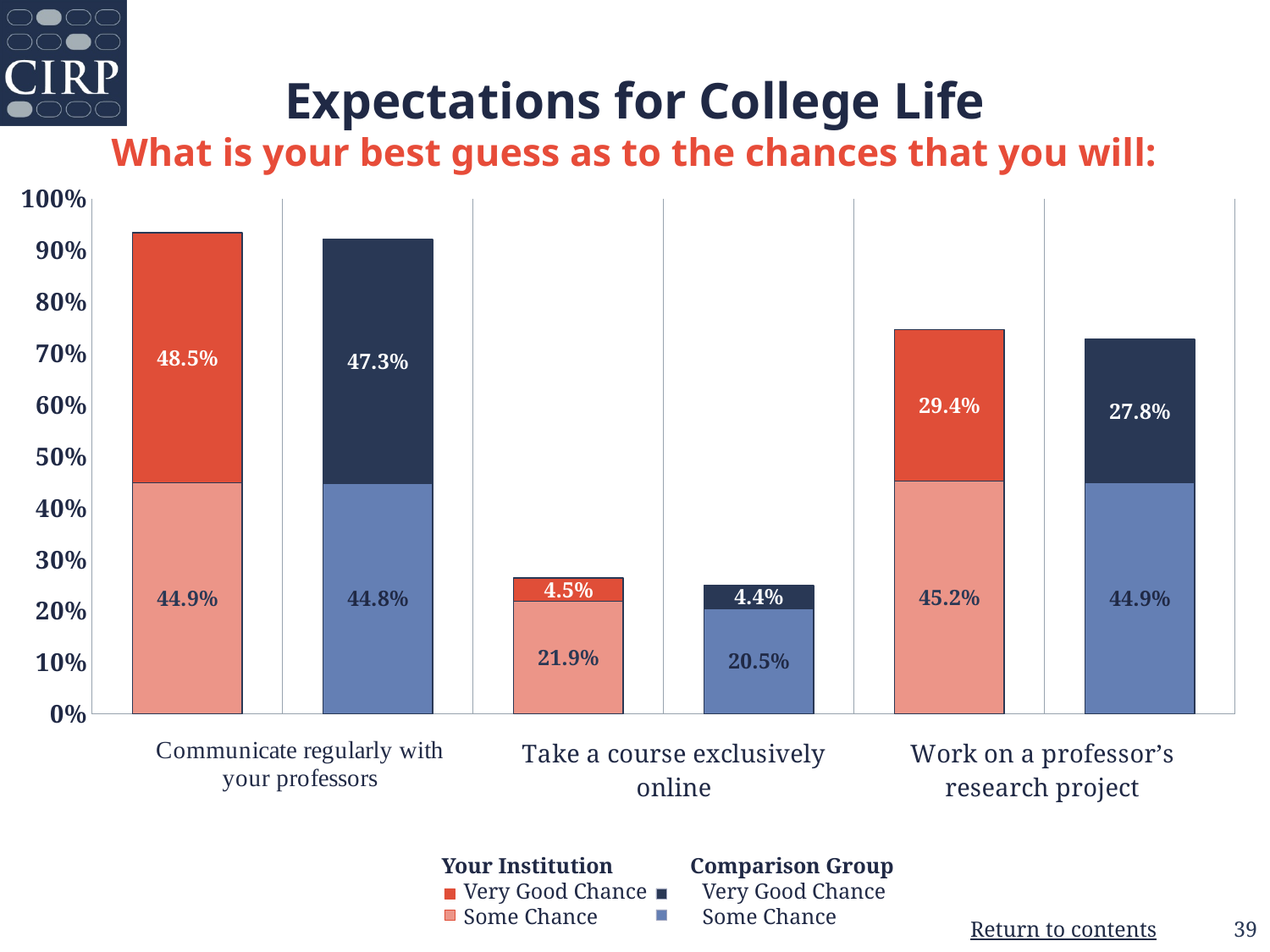
Which activity has the highest Some Chance value for the Comparison Group? Work on a professor's research project What percentage of Your Institution students said there is a Very Good Chance they will communicate regularly with their professors? 48.5% How many entries does the legend list? 4 What type of chart is shown on the slide? Stacked bar chart What is the difference between the Your Institution and Comparison Group Very Good Chance values for 'Work on a professor's research project'? 1.6% For 'Communicate regularly with your professors', is the Very Good Chance value larger for Your Institution or the Comparison Group? Your Institution What is the total stacked value for the Comparison Group bar for 'Work on a professor's research project'? 72.7% Which activity has the lowest Very Good Chance value for Your Institution? Take a course exclusively online Is the total stacked value of the Your Institution bar for 'Communicate regularly with your professors' greater or less than 90%? greater What is the total stacked value for the Your Institution bar for 'Take a course exclusively online'? 26.4% What percentage of the Comparison Group said there is Some Chance they will take a course exclusively online? 20.5% What percentage of the Comparison Group said there is a Very Good Chance they will work on a professor's research project? 27.8%